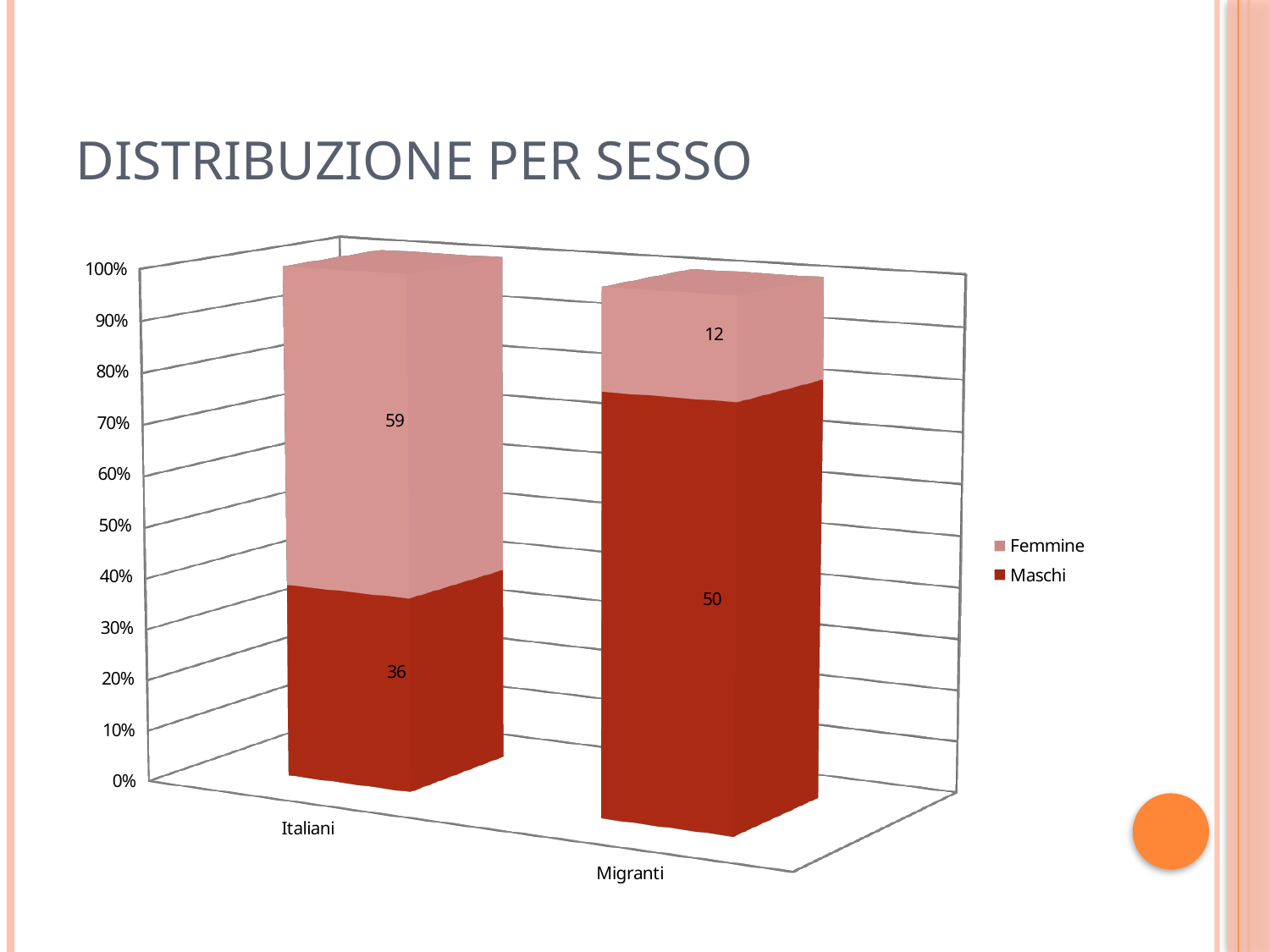
What is the sum of the two data labels shown on the Italiani bar? 95 What is the title of the chart on this slide? DISTRIBUZIONE PER SESSO Which category has the lower Femmine value? Migranti What is the data label for Maschi in the Italiani bar? 36 What is the data label for Maschi in the Migranti bar? 50 What is the data label for Femmine in the Italiani bar? 59 How many series does the legend list? 2 Which category has the higher Maschi value, Italiani or Migranti? Migranti What is the difference between the Femmine values for Italiani and Migranti? 47 What is the data label for Femmine in the Migranti bar? 12 How many categories are shown on the x axis? 2 What is the difference between the Maschi values for Migranti and Italiani? 14